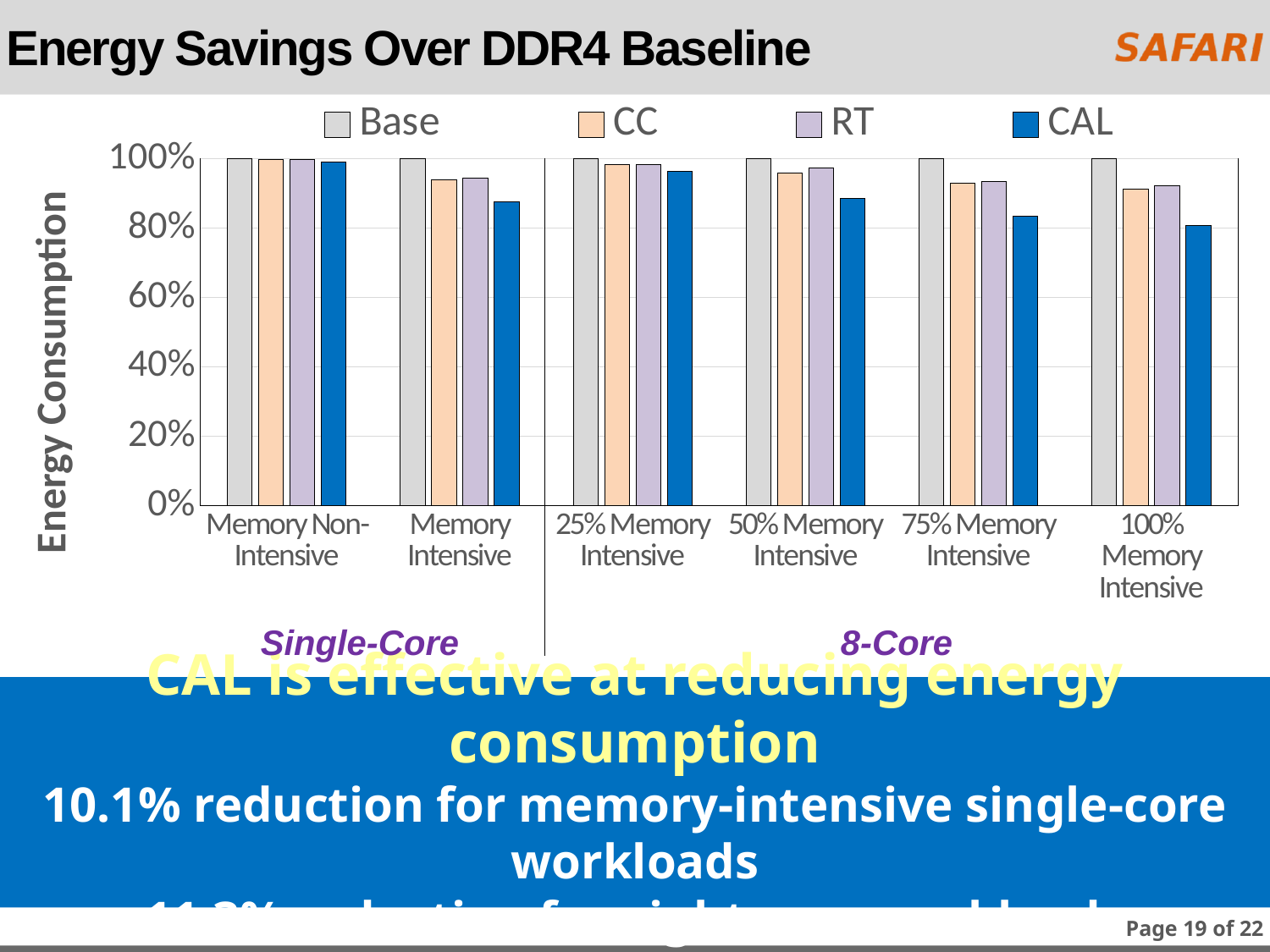
Do the CAL values rise or fall going from 25% Memory Intensive to 100% Memory Intensive? fall What is the title of the slide? Energy Savings Over DDR4 Baseline Which series has the highest bar in the 50% Memory Intensive category? Base In the Memory Intensive category, which is larger, the CC bar or the CAL bar? CC Is the CC value for the 100% Memory Intensive category greater or less than 100%? less What is the label on the y axis? Energy Consumption Is the CAL value for the Memory Intensive category greater or less than 80%? greater Which series has the lowest bar in the 100% Memory Intensive category? CAL What is the Base value for the Memory Non-Intensive category? 100% How many workload categories are shown along the x axis? 6 What kind of chart is shown on the slide? bar chart How many series does the legend list? 4